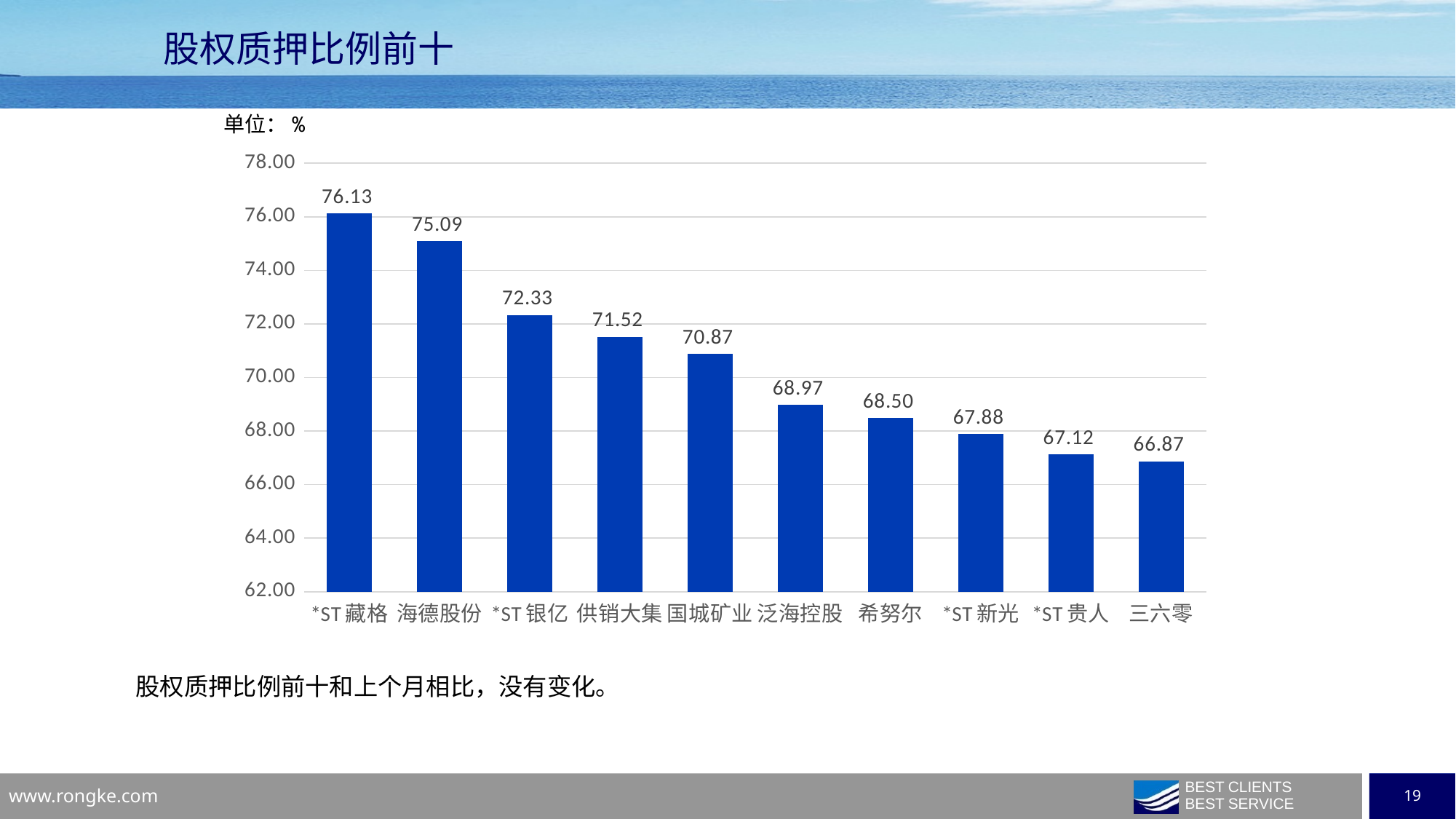
How many categories are shown in the chart? 10 Which category has the lowest value? 三六零 What is the value for 海德股份? 75.09 What is the difference between the values for *ST 银亿 and 供销大集? 0.81 Is the value for *ST 新光 greater or less than 70.00? less What is the value for 三六零? 66.87 Which category has the highest value? *ST 藏格 Which is larger, the value for 国城矿业 or the value for 希努尔? 国城矿业 What is the value for 泛海控股? 68.97 Do the values rise or fall from left to right along the x axis? fall What kind of chart is shown on the slide? bar chart What is the difference between the values for *ST 藏格 and 海德股份? 1.04